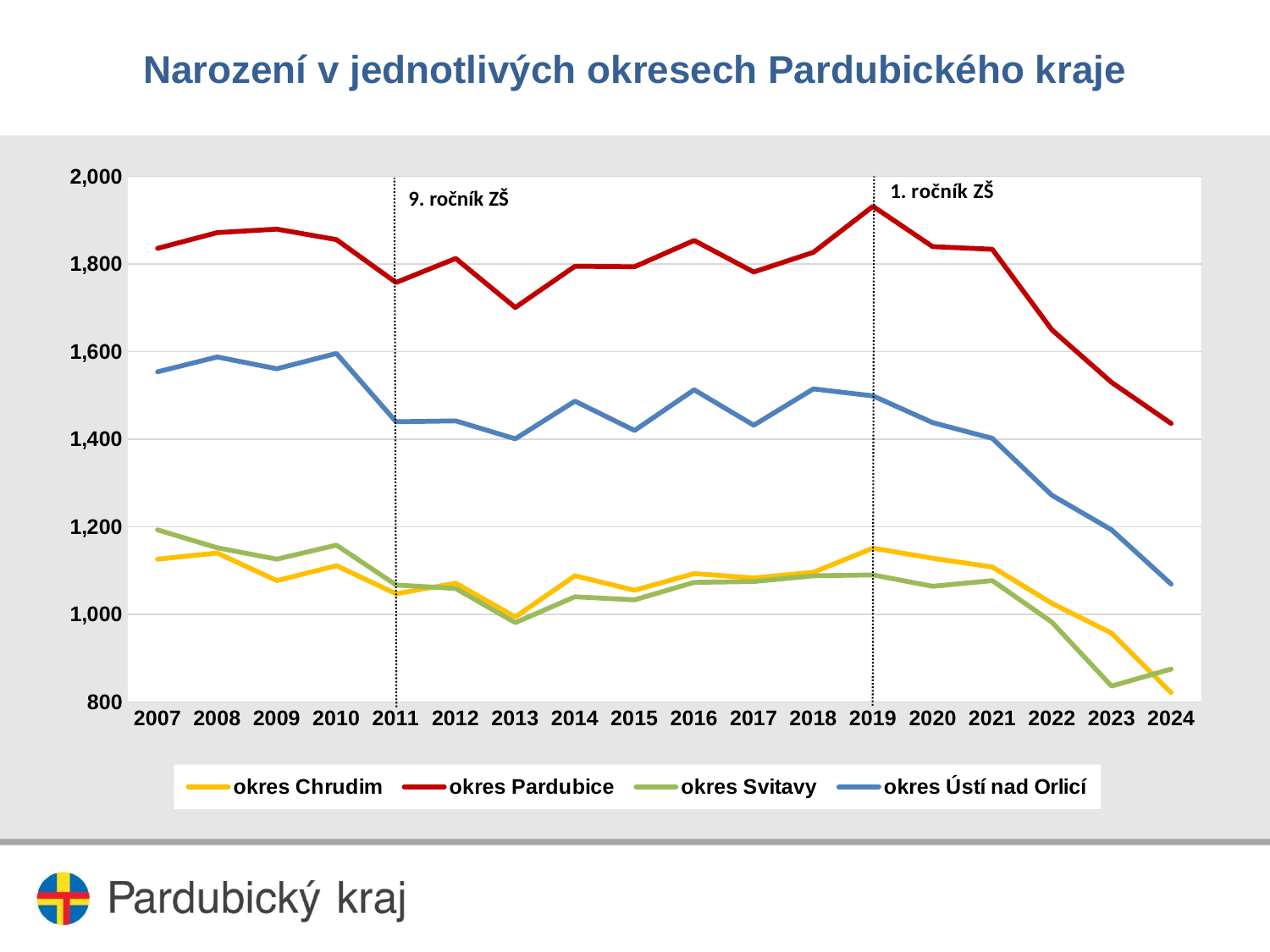
What kind of chart is shown on the slide? line chart In which year does okres Pardubice reach its highest value? 2019 Which district has the lowest number of births in 2024? okres Chrudim How many years are shown on the x axis? 18 Is the value for okres Ústí nad Orlicí in 2024 greater or less than 1,200? less How many series does the legend list? 4 Is the value for okres Svitavy in 2023 greater or less than 1,000? less Which district has the highest number of births in 2024? okres Pardubice What label is attached to the vertical dotted line at 2019? 1. ročník ZŠ Is the value for okres Pardubice in 2019 greater or less than 1,800? greater Does the value for okres Pardubice rise or fall from 2019 to 2024? fall In 2007, which is larger: the value for okres Svitavy or the value for okres Chrudim? okres Svitavy